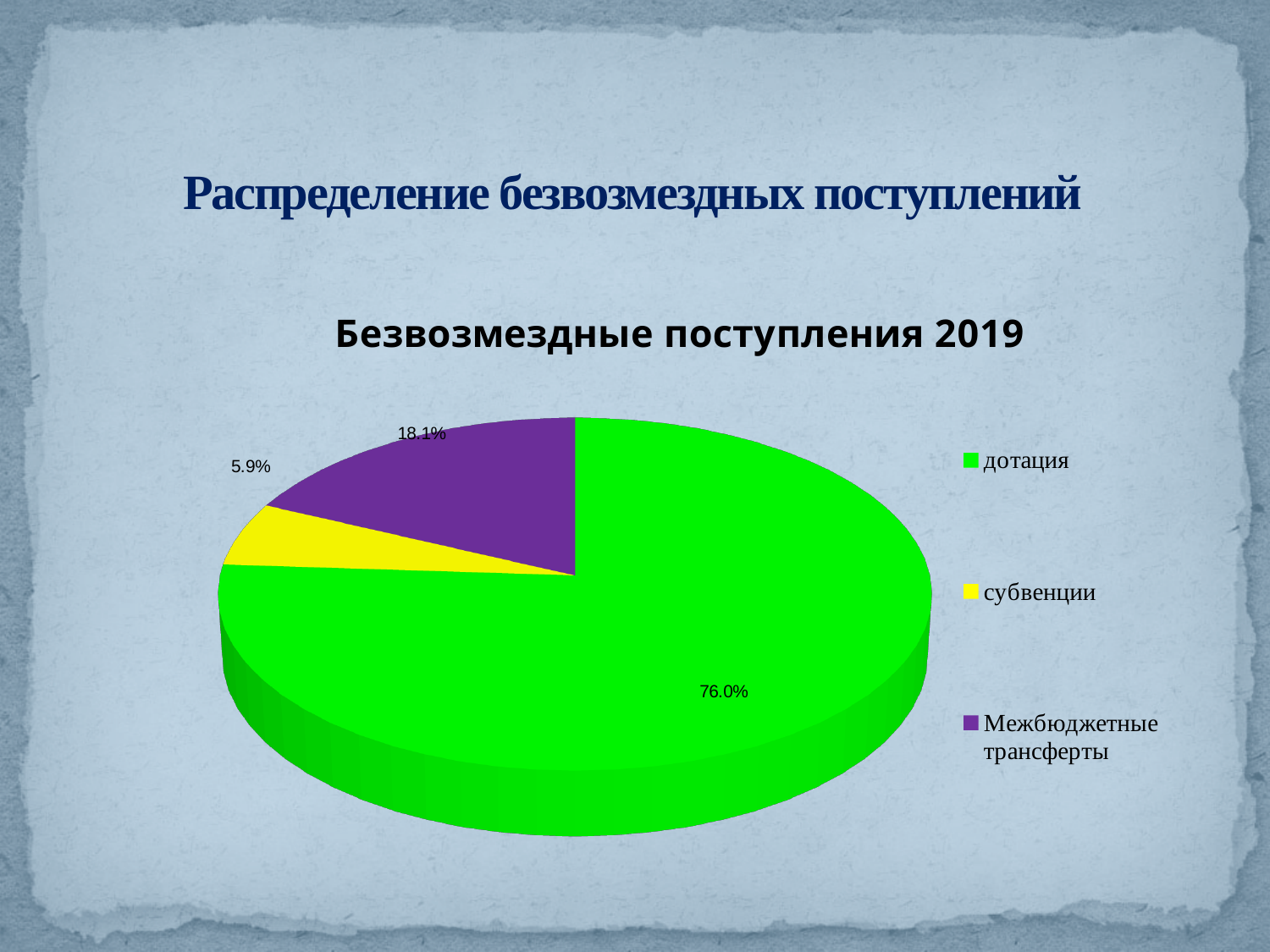
What colour is the slice for субвенции? yellow How many slices does the pie chart have? 3 What share of the pie does субвенции have? 5.9% Which category has the largest slice of the pie? дотация How many entries does the legend list? 3 What kind of chart is shown on the slide? pie chart What is the chart's title? Безвозмездные поступления 2019 What share of the pie does дотация have? 76.0% What share of the pie does Межбюджетные трансферты have? 18.1% Which category has the smallest slice of the pie? субвенции What is the difference between the shares of дотация and Межбюджетные трансферты? 57.9% Which is larger, the share of Межбюджетные трансферты or the share of субвенции? Межбюджетные трансферты